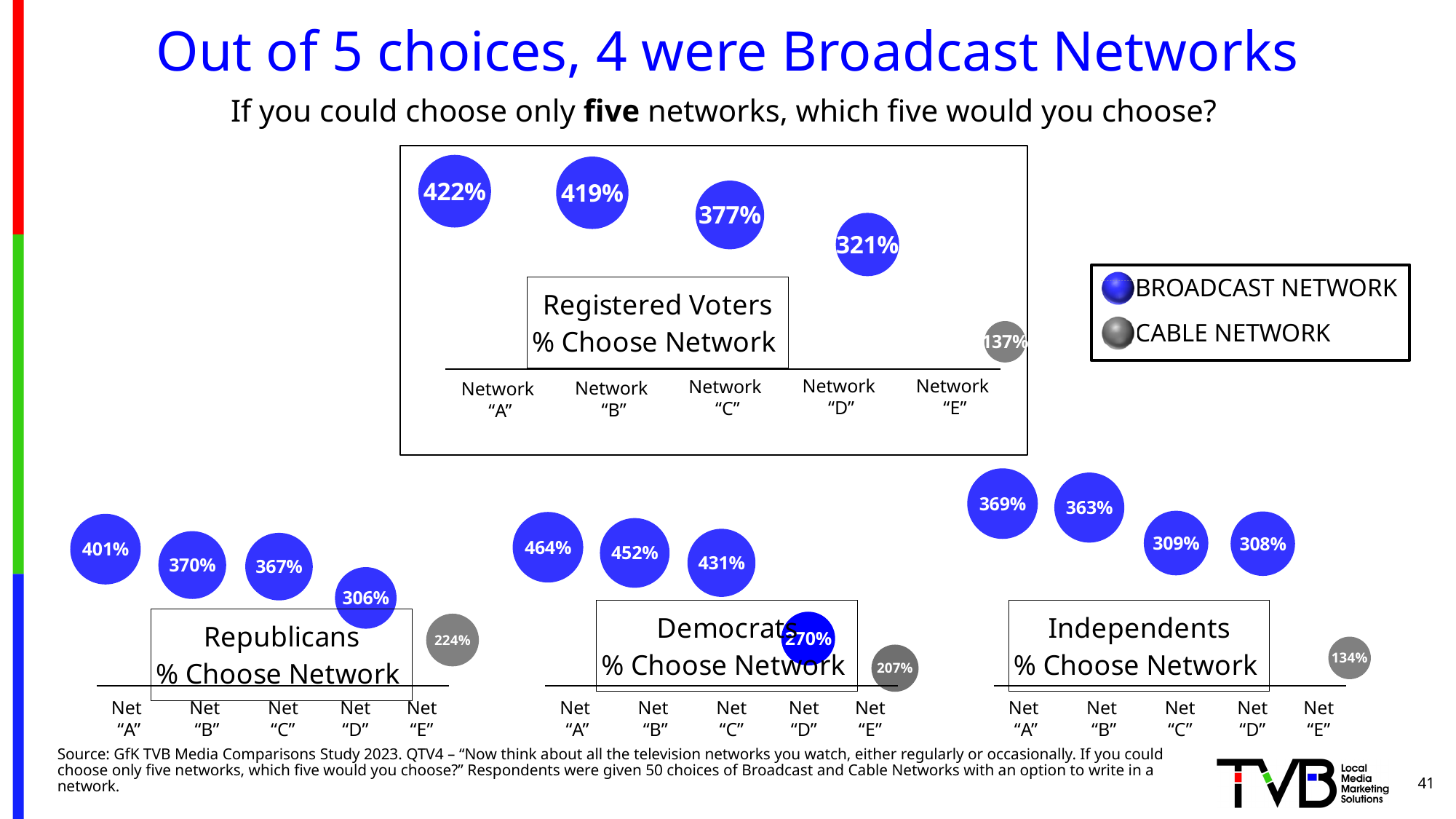
How many networks are shown in the Registered Voters chart? 5 In the Republicans chart, which network has the highest value? Net "A" In the Democrats chart, what is the value for Net "B"? 452% In the Registered Voters chart, what percentage chose Network "A"? 422% In the Registered Voters chart, what percentage chose Network "E"? 137% In the Independents chart, which is larger, the value for Net "A" or Net "C"? Net "A" In the Independents chart, what is the value for Net "E"? 134% In the Democrats chart, what is the difference between the values for Net "A" and Net "C"? 33% In the Democrats chart, which network has the lowest value? Net "E" In the Republicans chart, what is the value for Net "D"? 306% According to the legend, what colour represents a cable network? Gray In the Republicans chart, what is the difference between the values for Net "A" and Net "E"? 177%